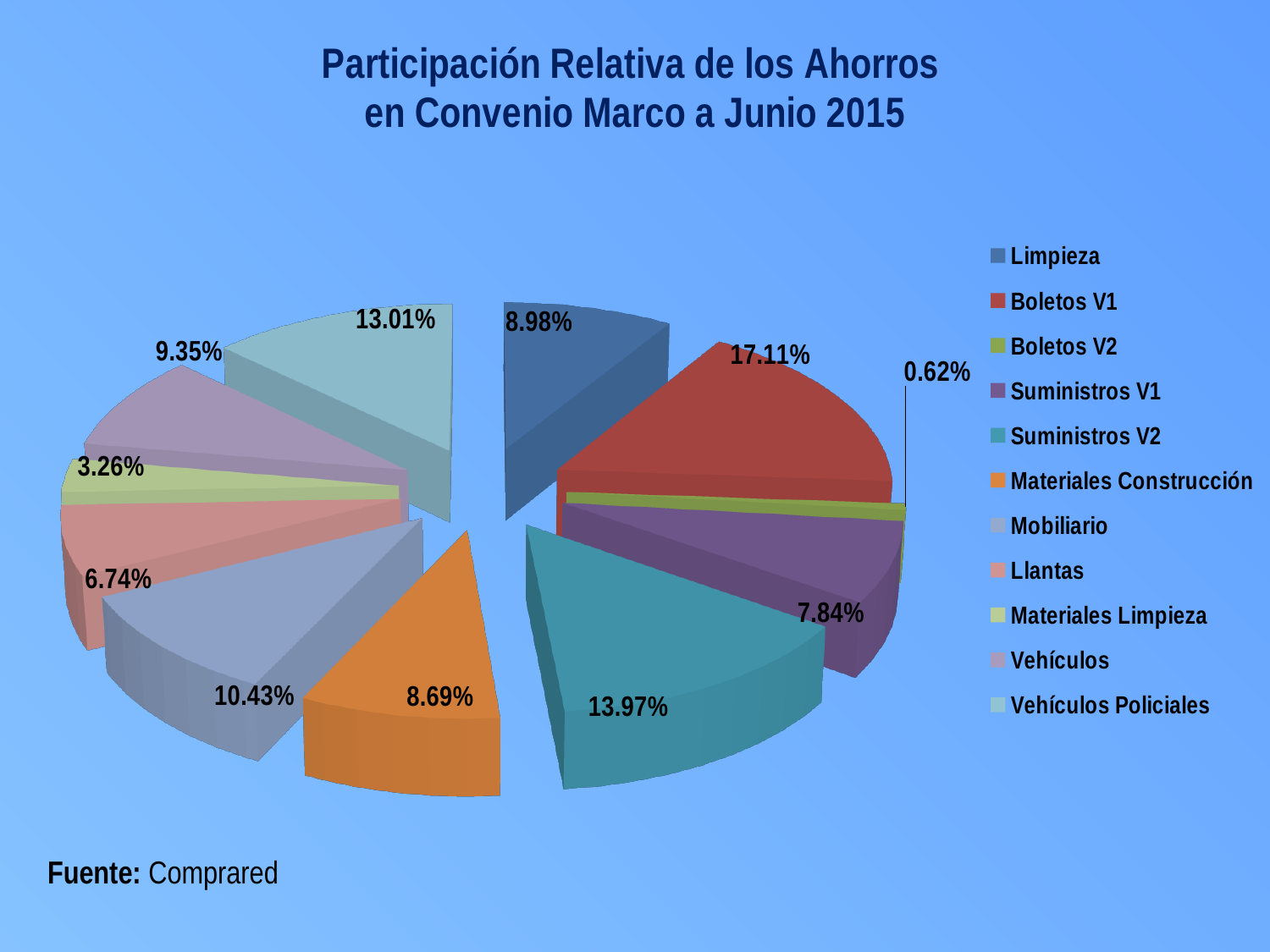
What is the value shown for Suministros V2? 13.97% What is the difference between the shares of Boletos V1 and Suministros V2? 3.14% What is the value shown for Vehículos Policiales? 13.01% Which category has the largest share of the pie? Boletos V1 What is the title of the chart? Participación Relativa de los Ahorros en Convenio Marco a Junio 2015 Which category has the smallest share of the pie? Boletos V2 How many categories does the pie chart contain? 11 What source is cited for the chart? Comprared Which is larger, the share for Limpieza or the share for Materiales Construcción? Limpieza What is the value shown for Mobiliario? 10.43% What type of chart is shown on the slide? Pie chart What share of the pie does Boletos V1 represent? 17.11%